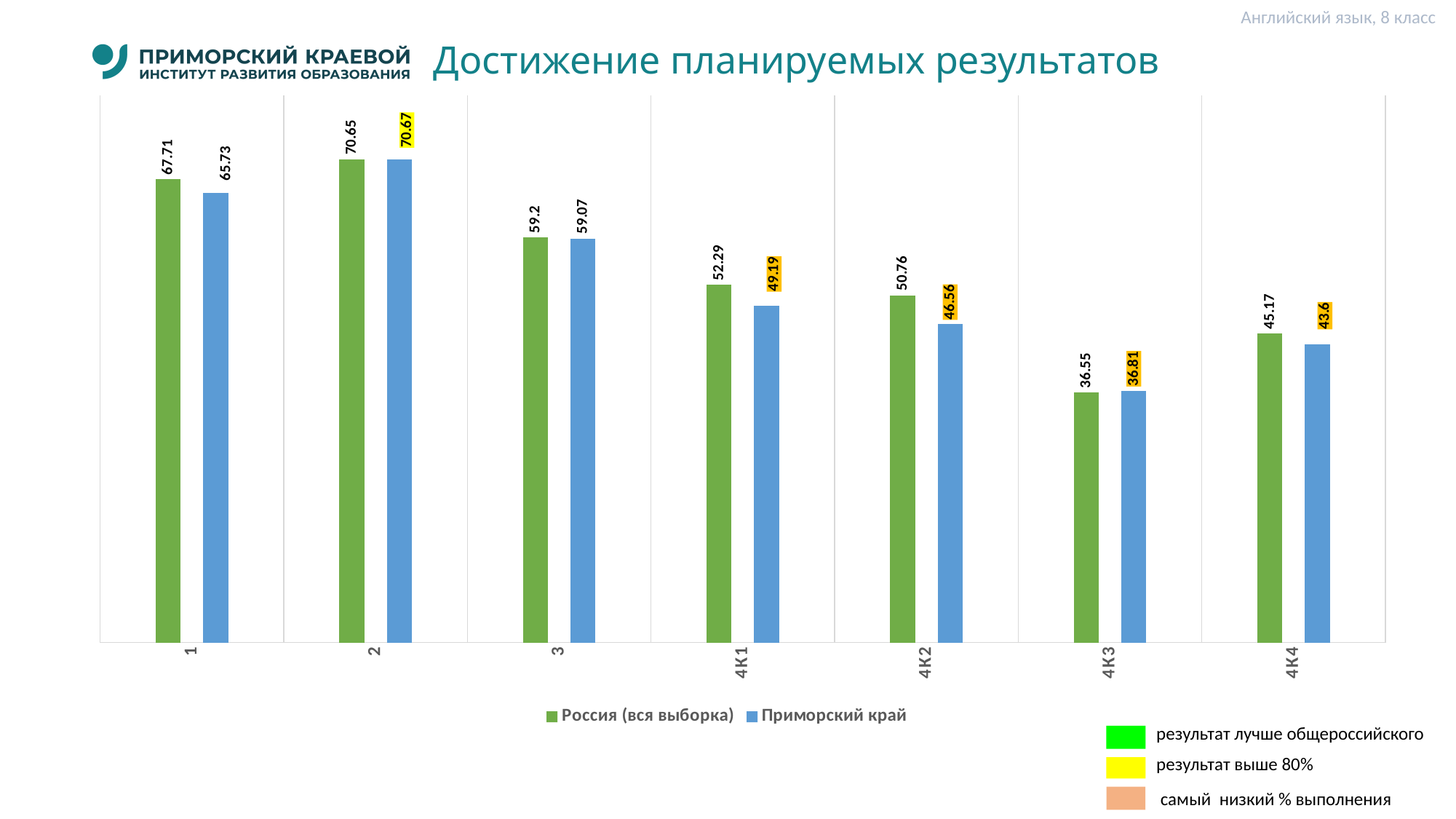
How many series does the legend list? 2 What is the difference between Россия (вся выборка) and Приморский край in category 4К2? 4.2 What is the value for Приморский край in category 4К4? 43.6 Which is larger in category 4К1: Россия (вся выборка) or Приморский край? Россия (вся выборка) What colour are the bars for Приморский край? Blue Which category has the lowest value for Приморский край? 4К3 What is the difference between Россия (вся выборка) and Приморский край in category 1? 1.98 What is the value for Россия (вся выборка) in category 3? 59.2 What is the value for Приморский край in category 4К1? 49.19 What kind of chart is shown on the slide? Bar chart How many categories are shown on the x axis? 7 Which category has the highest value for Россия (вся выборка)? 2